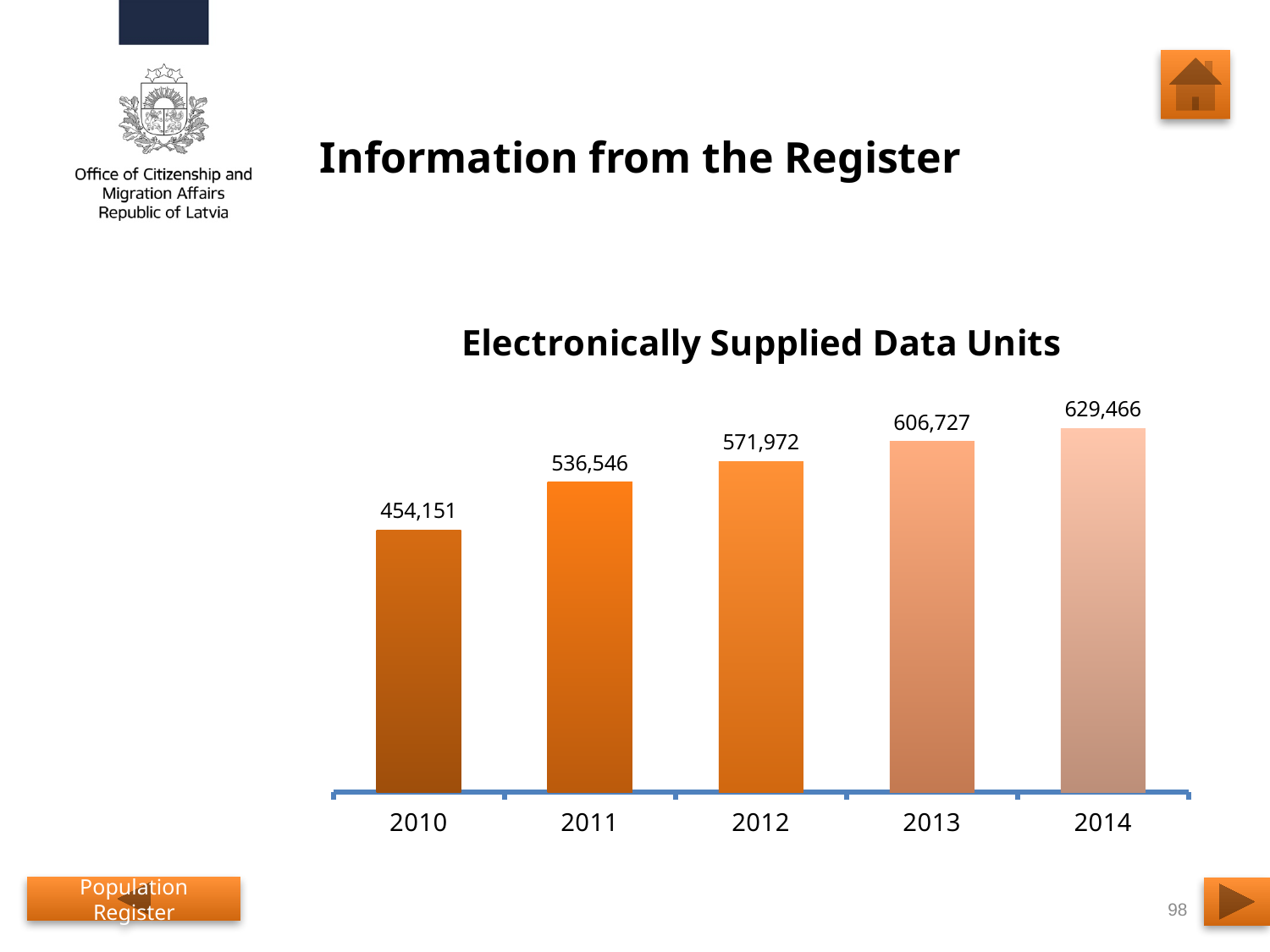
How many years are shown on the chart? 5 What is the value for 2010? 454,151 What is the value for 2014? 629,466 Which is larger, the value for 2012 or the value for 2013? 2013 Which year has the lowest value? 2010 What kind of chart is shown? bar chart Which year has the highest value? 2014 Do the values rise or fall from 2010 to 2014? rise What is the title of the chart? Electronically Supplied Data Units What is the difference between the values for 2011 and 2010? 82,395 What is the difference between the values for 2014 and 2013? 22,739 What is the value for 2012? 571,972